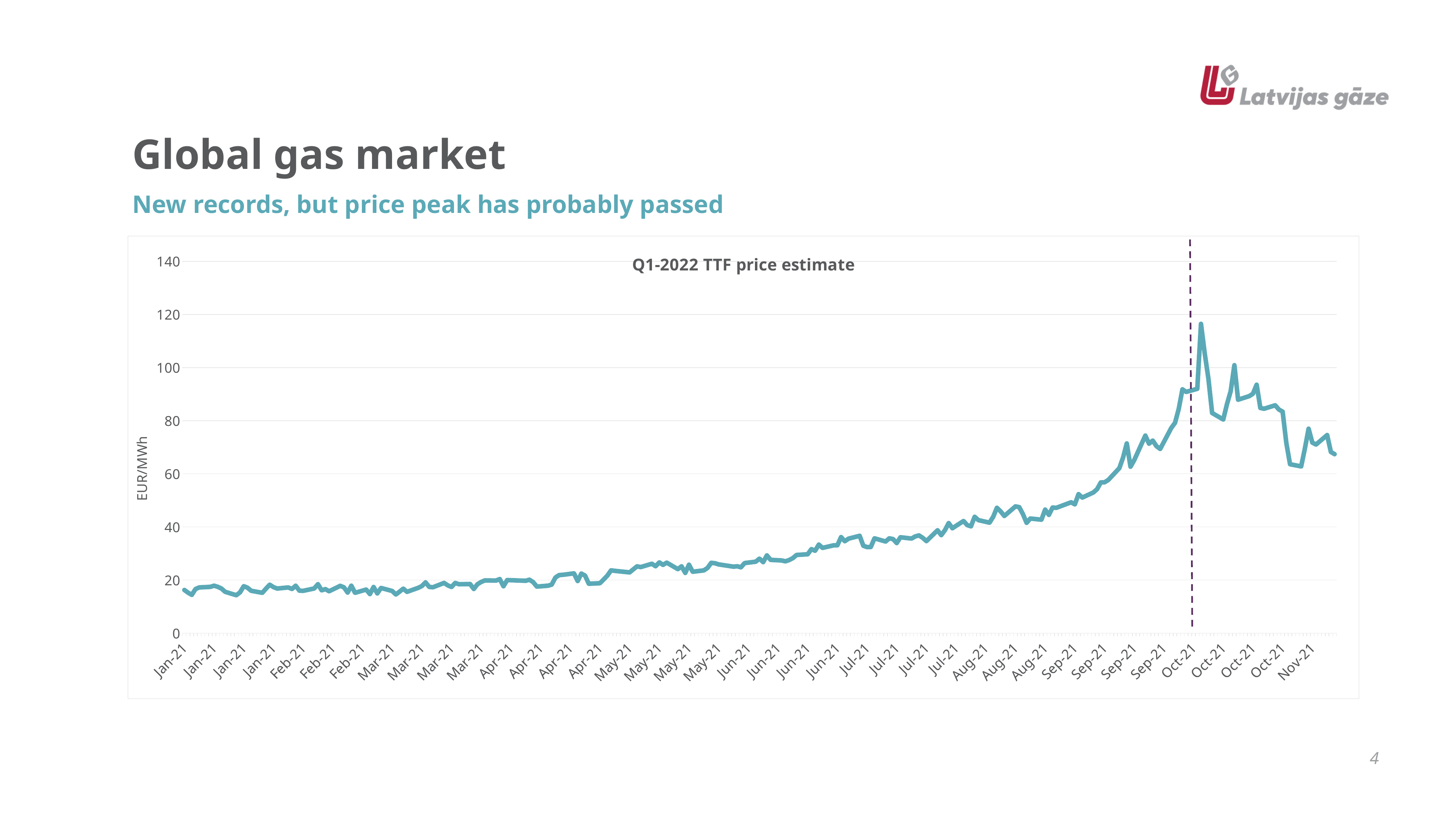
In which month does the line reach its highest value? Oct-21 Is the peak value of the line greater or less than 100? greater Is the value at the start of Jan-21 greater or less than 20? less Which is larger, the peak value in Oct-21 or the value in Jan-21? Oct-21 Do the values rise or fall from the Oct-21 peak to the end of the line in Nov-21? fall Is the value in mid Jun-21 greater or less than 40? less What unit is shown on the y-axis of the chart? EUR/MWh What kind of chart is shown on the slide? line chart What is the title of the chart? Q1-2022 TTF price estimate Overall, do the values rise or fall from Jan-21 to Oct-21? rise Which is larger, the value in Sep-21 or the value in Mar-21? Sep-21